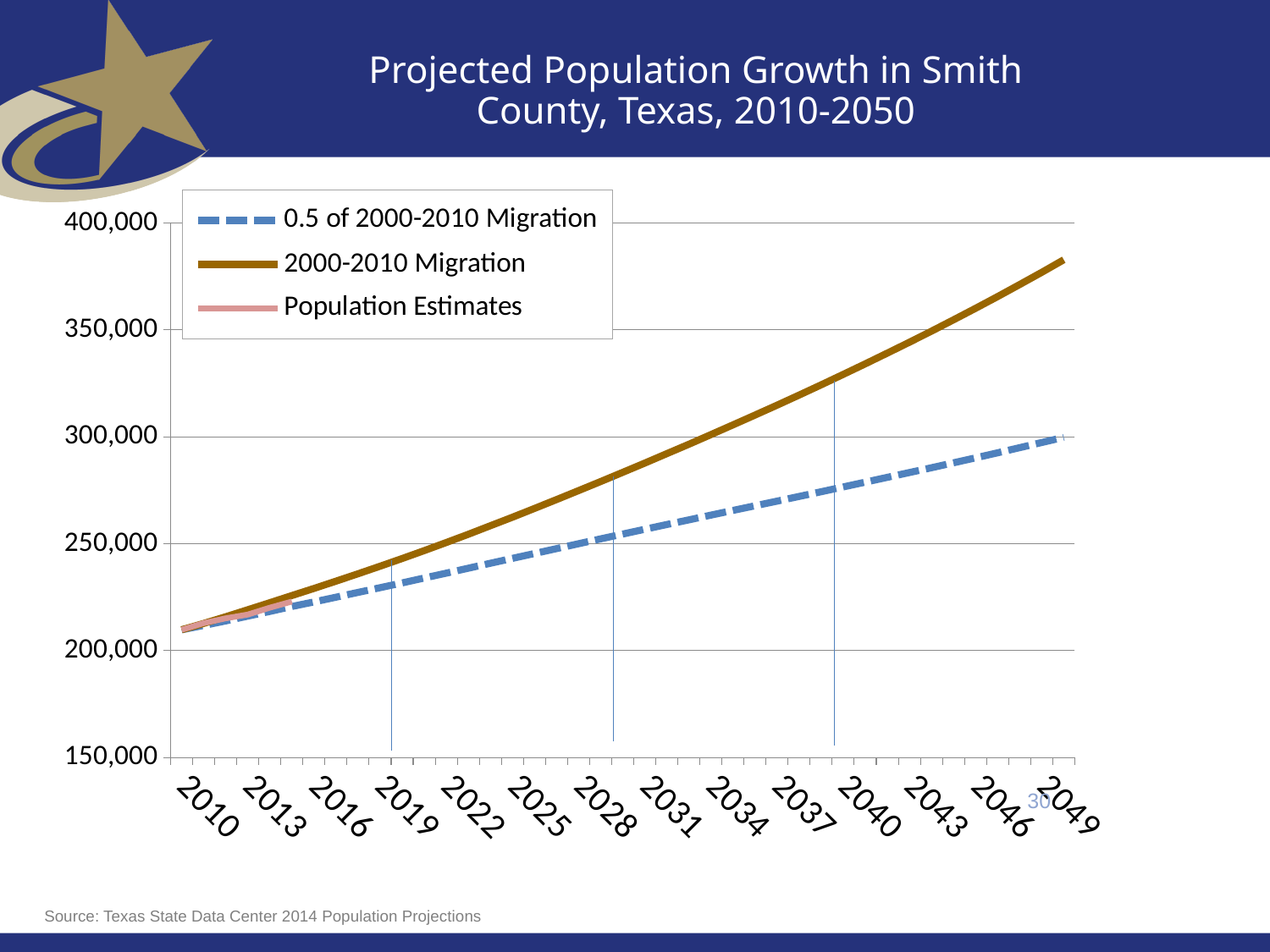
What is the title of the chart? Projected Population Growth in Smith County, Texas, 2010-2050 Does the 0.5 of 2000-2010 Migration series rise or fall across the years shown? rise How many series does the legend list? 3 Does the 2000-2010 Migration series rise or fall from 2010 to 2049? rise Is the value of the 0.5 of 2000-2010 Migration series at 2040 greater or less than 300,000? less Is the value of the 0.5 of 2000-2010 Migration series at 2040 greater or less than 250,000? greater How many year labels are shown along the x axis? 14 Is the value of the 2000-2010 Migration series at 2040 greater or less than 300,000? greater What kind of chart is shown on the slide? line chart Which series in the legend is drawn with a dashed line? 0.5 of 2000-2010 Migration At 2049, which series is higher: 2000-2010 Migration or 0.5 of 2000-2010 Migration? 2000-2010 Migration